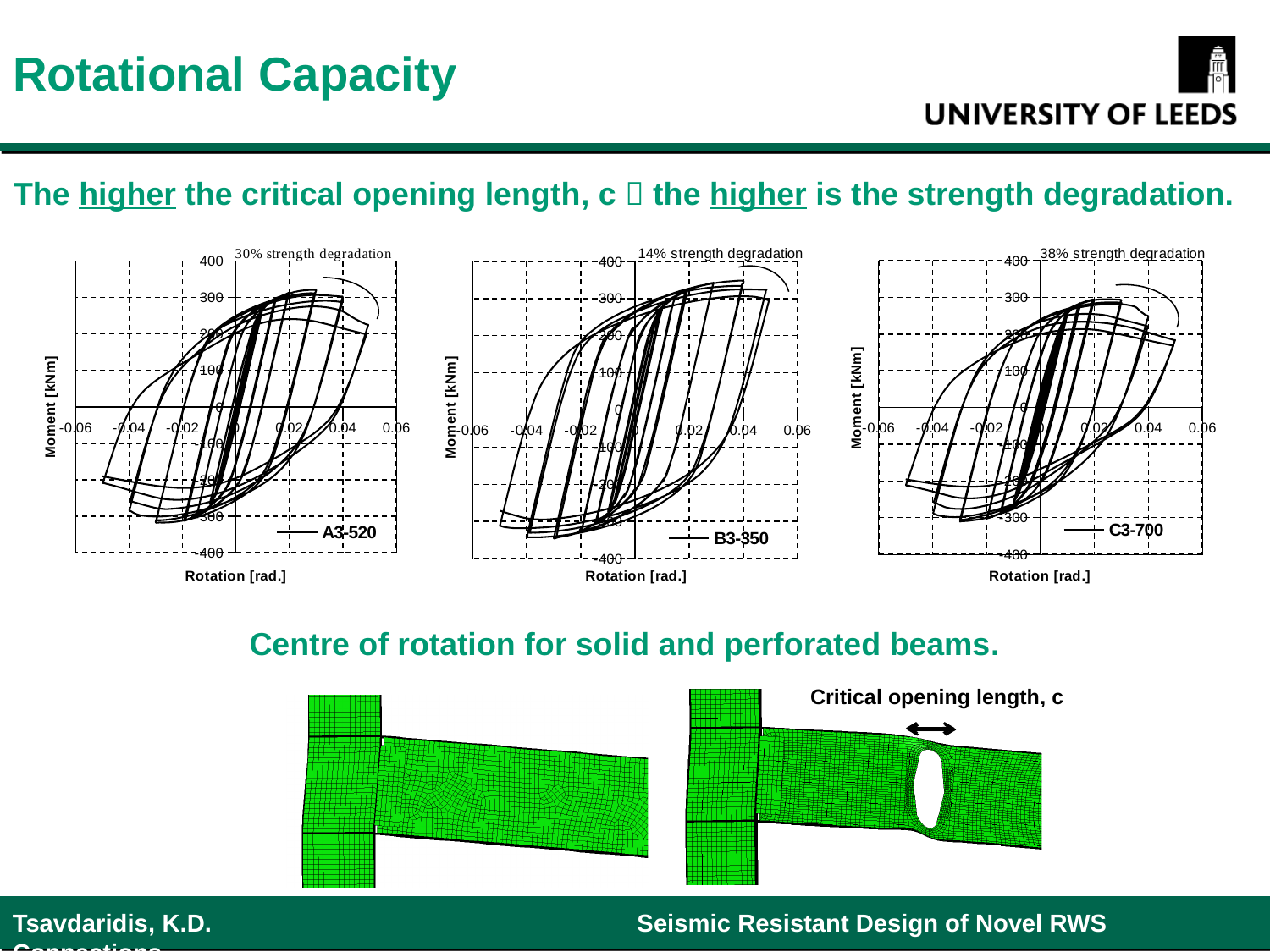
How many series does the legend of the middle chart (B3-350) list? 1 Which has the higher strength degradation, A3-520 or B3-350? A3-520 What percentage strength degradation is annotated on the middle chart (B3-350)? 14% What percentage strength degradation is annotated on the right chart (C3-700)? 38% What percentage strength degradation is annotated on the left chart (A3-520)? 30% How many hysteresis charts are shown on the slide? 3 What is the difference in strength degradation between the C3-700 chart and the B3-350 chart? 24% What kind of chart is the left chart (A3-520)? Line chart Across the three charts, which specimen shows the highest strength degradation? C3-700 What is the y-axis label on the right chart (C3-700)? Moment [kNm] Across the three charts, which specimen shows the lowest strength degradation? B3-350 What is the difference in strength degradation between the C3-700 chart and the A3-520 chart? 8%